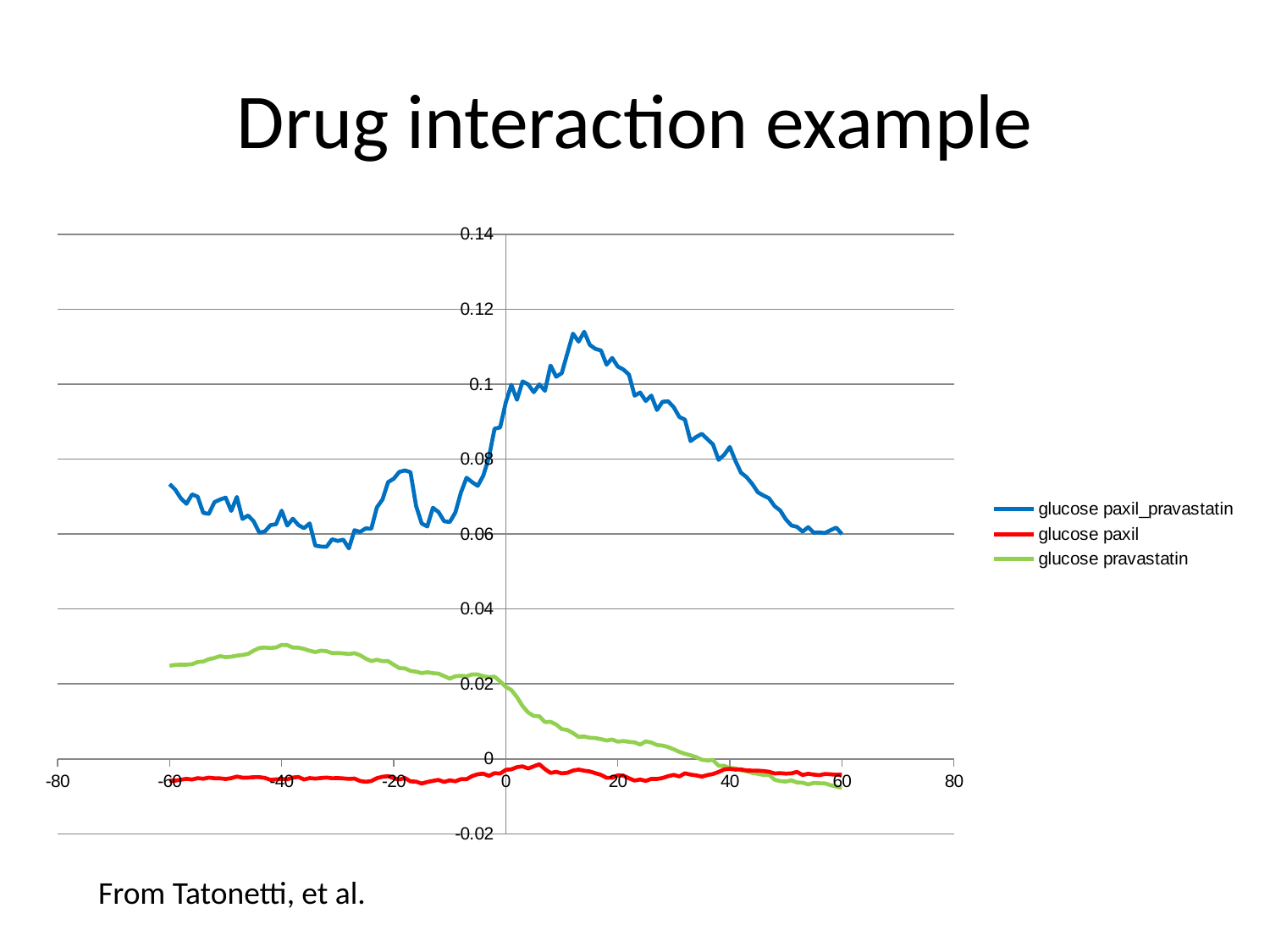
What kind of chart is shown on the slide? line chart Is the value for glucose paxil at x = 20 greater or less than 0.02? less Is the value for glucose paxil_pravastatin at x = 0 greater or less than 0.08? greater How many series does the legend list? 3 Is the value for glucose pravastatin at x = -40 greater or less than 0.04? less Does the glucose pravastatin line rise or fall between x = 0 and x = 60? fall What are the three series named in the legend? glucose paxil_pravastatin, glucose paxil, glucose pravastatin Which series has the highest values across the chart? glucose paxil_pravastatin At x = 0, which is larger: glucose paxil_pravastatin or glucose pravastatin? glucose paxil_pravastatin Which series is drawn with the blue line? glucose paxil_pravastatin